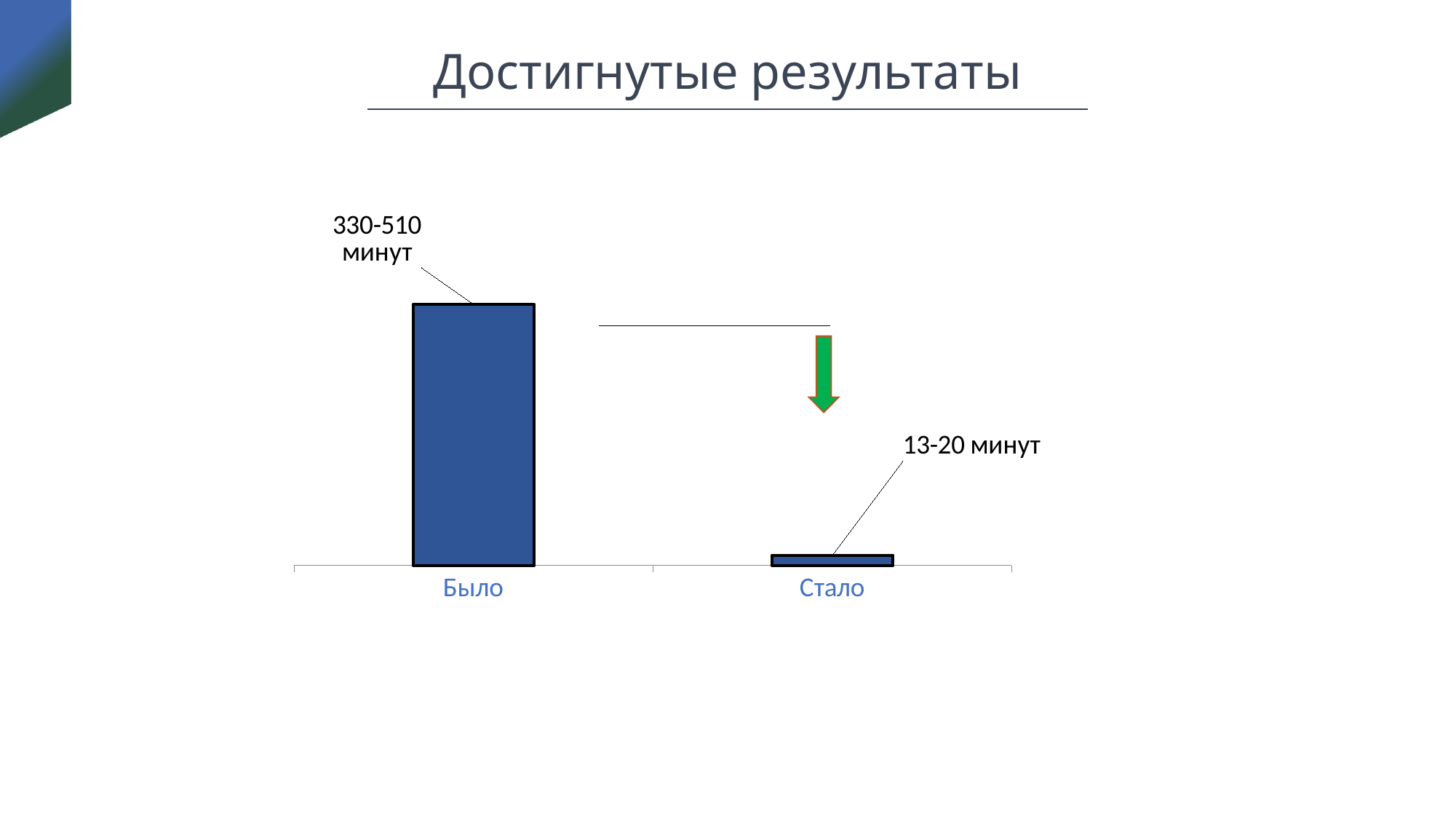
Which bar is taller, "Было" or "Стало"? Было What is the data label shown for the "Было" bar? 330-510 минут What is the title of the slide containing the chart? Достигнутые результаты How many categories are shown on the x axis? 2 What kind of chart is shown on the slide? bar chart What is the data label shown for the "Стало" bar? 13-20 минут Which category has the lowest bar? Стало What colour are the bars in the chart? blue Which category has the highest bar? Было Do the values rise or fall from "Было" to "Стало"? fall